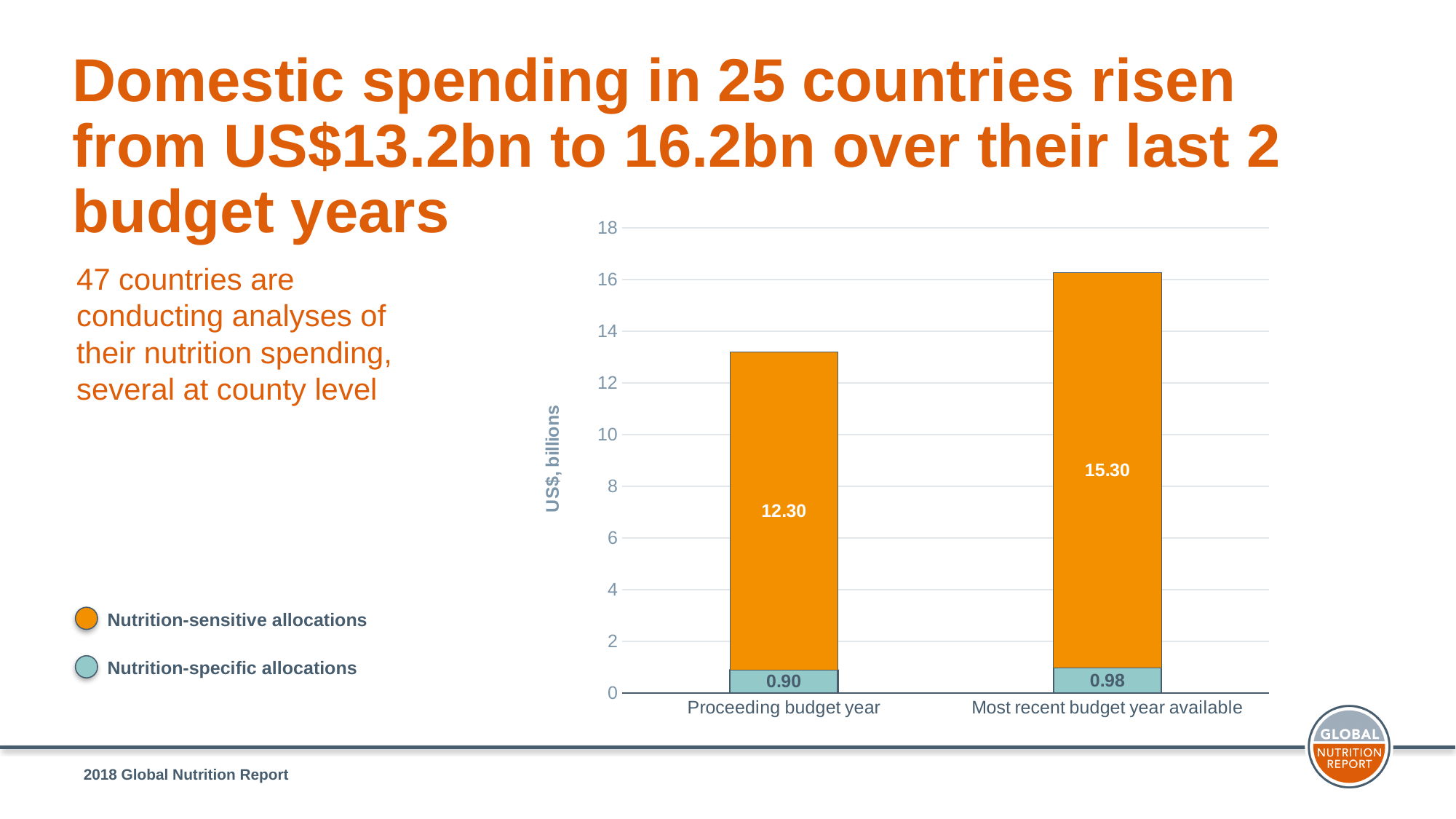
What kind of chart is shown on the slide? Stacked bar chart How many categories are shown on the x axis? 2 How many series does the legend list? 2 What is the value of Nutrition-specific allocations for the Proceeding budget year? 0.90 What is the value of Nutrition-specific allocations for the Most recent budget year available? 0.98 What is the value of Nutrition-sensitive allocations for the Proceeding budget year? 12.30 Is the total for the Most recent budget year available greater or less than 16? greater What is the difference in Nutrition-sensitive allocations between the Most recent budget year available and the Proceeding budget year? 3.00 What is the value of Nutrition-sensitive allocations for the Most recent budget year available? 15.30 What is the total of the stacked bar for the Proceeding budget year? 13.20 Which budget year has the larger Nutrition-sensitive allocation? Most recent budget year available What is the label of the y axis? US$, billions